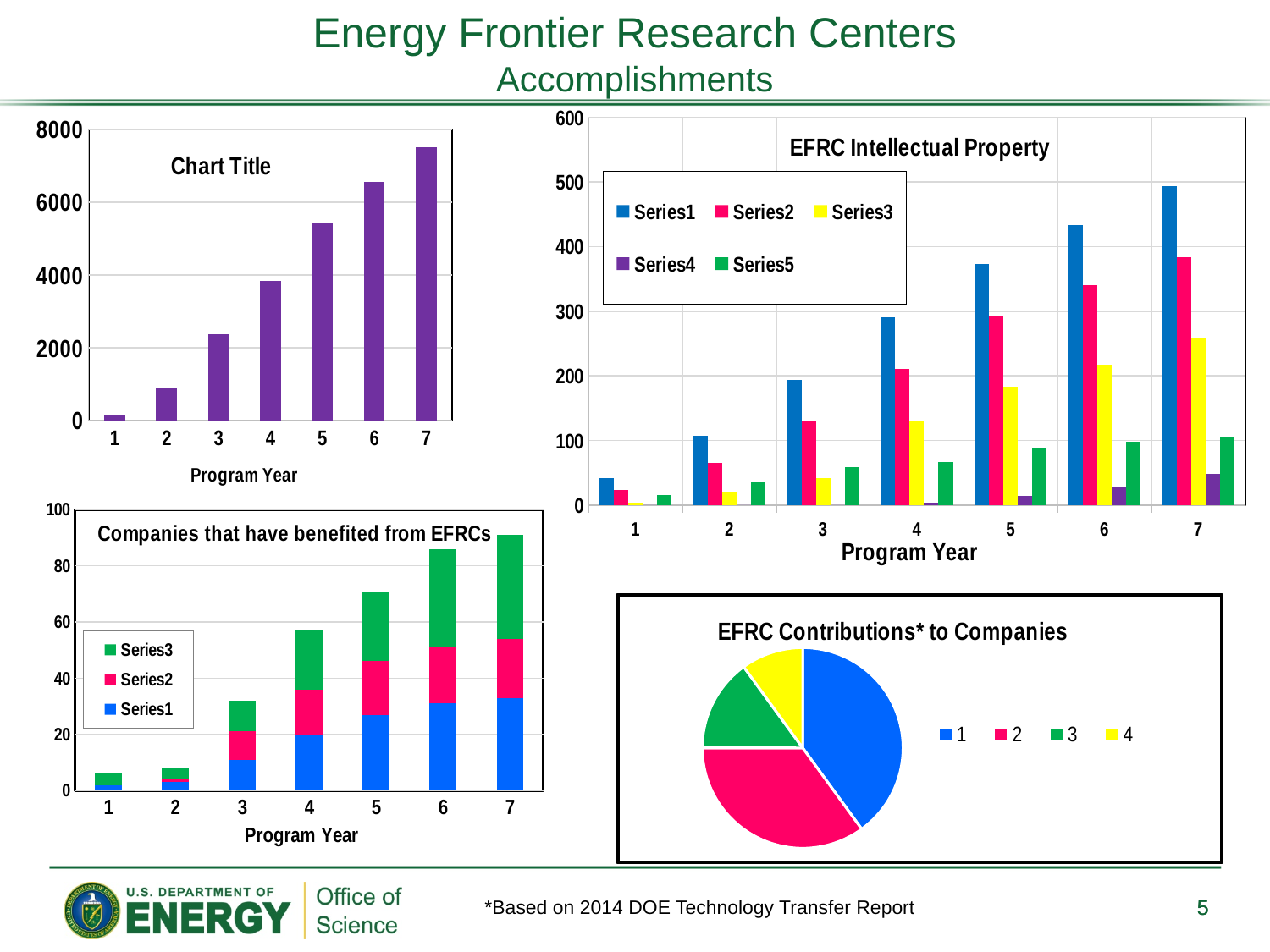
In the 'EFRC Intellectual Property' chart, is the Series1 value for program year 5 greater or less than 300? greater In the 'EFRC Intellectual Property' chart, which is larger in program year 6, Series1 or Series2? Series1 What kind of chart is 'EFRC Contributions* to Companies'? pie chart How many program years are shown on the x axis of the 'Companies that have benefited from EFRCs' chart? 7 In the 'Chart Title' chart, which program year has the lowest value? 1 In the 'Chart Title' chart, do the values rise or fall from program year 1 to program year 7? rise In the 'Companies that have benefited from EFRCs' chart, is the total stacked value for program year 7 greater or less than 80? greater In the 'Chart Title' chart, is the value for program year 7 greater or less than 6000? greater In the 'EFRC Contributions* to Companies' pie chart, which category has the smallest slice? 4 In the 'Chart Title' chart, which program year has the highest value? 7 How many series does the legend of the 'EFRC Intellectual Property' chart list? 5